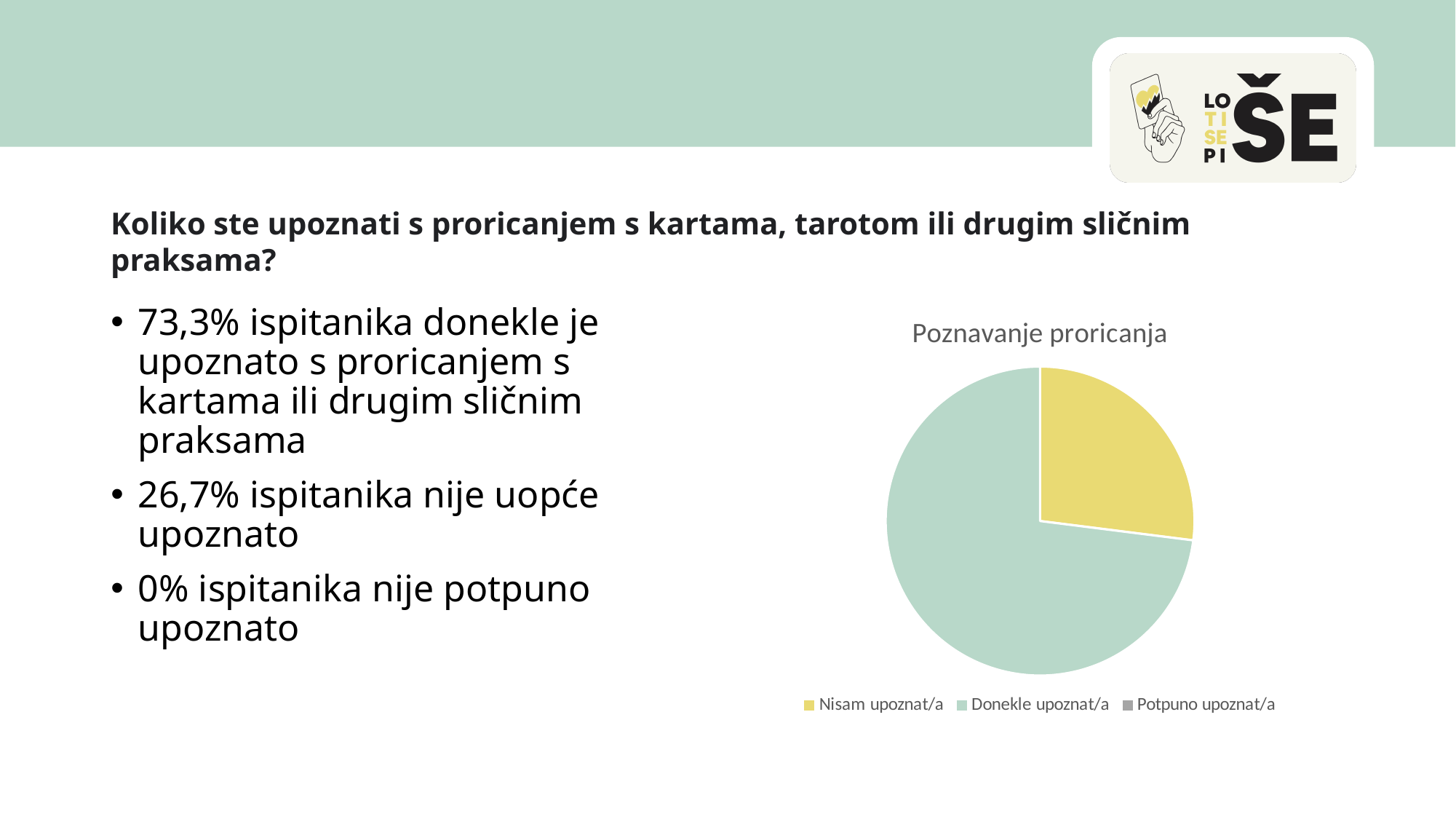
What share of respondents does the Donekle upoznat/a slice represent? 73,3% Which category has the smallest share of the pie? Potpuno upoznat/a What share of respondents does the Nisam upoznat/a slice represent? 26,7% What share of respondents does the Potpuno upoznat/a category represent? 0% What is the difference in percentage points between the Donekle upoznat/a share and the Nisam upoznat/a share? 46,6% Which colour represents Nisam upoznat/a in the pie chart? yellow Which is larger, the slice for Nisam upoznat/a or the slice for Donekle upoznat/a? Donekle upoznat/a How many categories does the chart legend list? 3 Which category has the largest share of the pie? Donekle upoznat/a What kind of chart is shown on the slide? pie chart How many slices are actually visible in the pie? 2 What is the title of the chart? Poznavanje proricanja